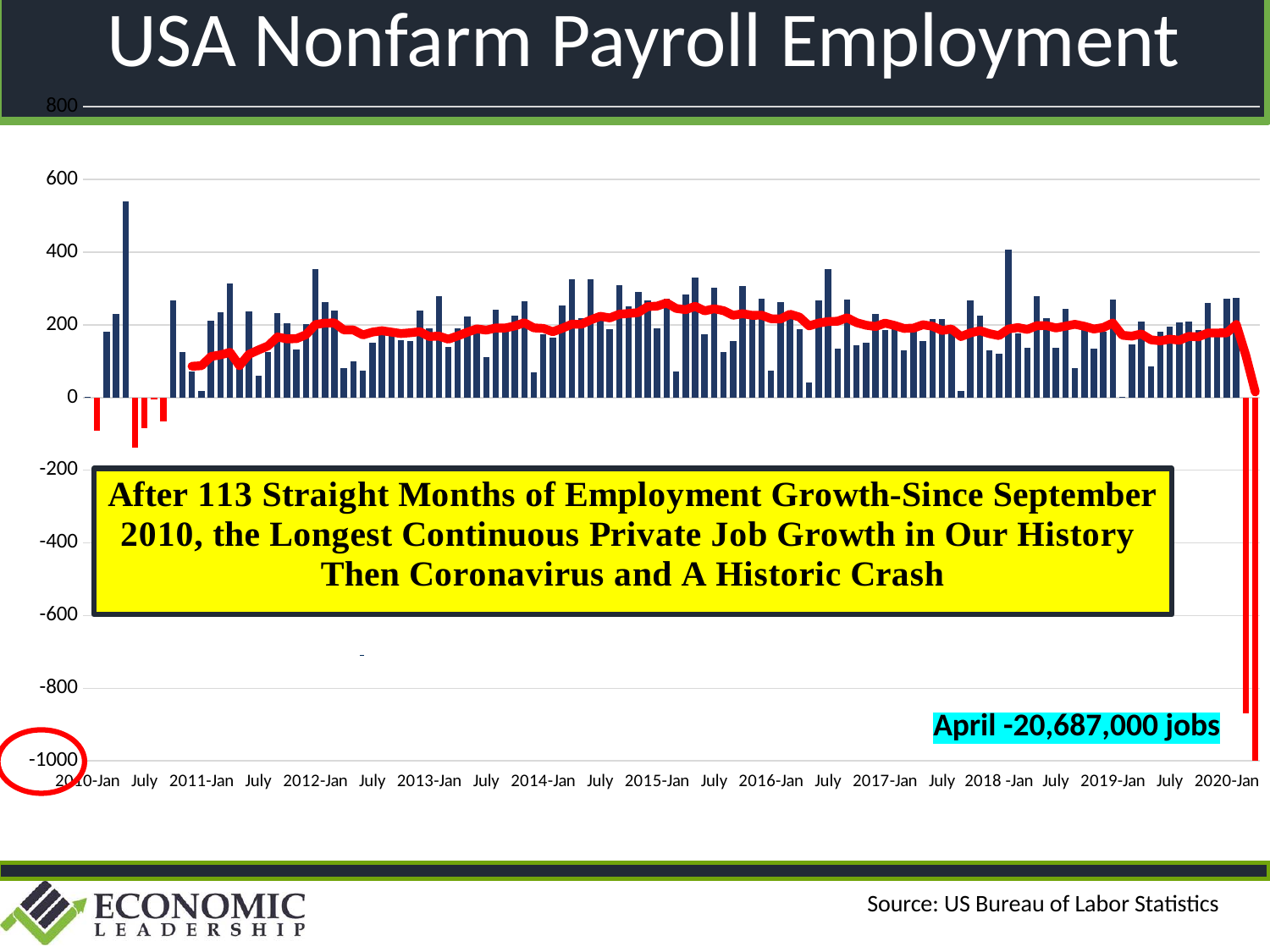
How many 'Jan' labels (years) appear on the x axis? 11 Is the tallest bar in 2010 greater or less than 400? greater According to the annotation on the chart, how many jobs were lost in April? -20,687,000 jobs Does the red line rise or fall between 2011-Jan and 2015-Jan? rise According to the text box, how many straight months of employment growth were there? 113 What is the highest value shown on the vertical axis? 800 What is the lowest value shown on the vertical axis? -1000 What is the title of the chart? USA Nonfarm Payroll Employment What kind of chart is shown on the slide? Bar chart Which month has the lowest value on the chart? April 2020